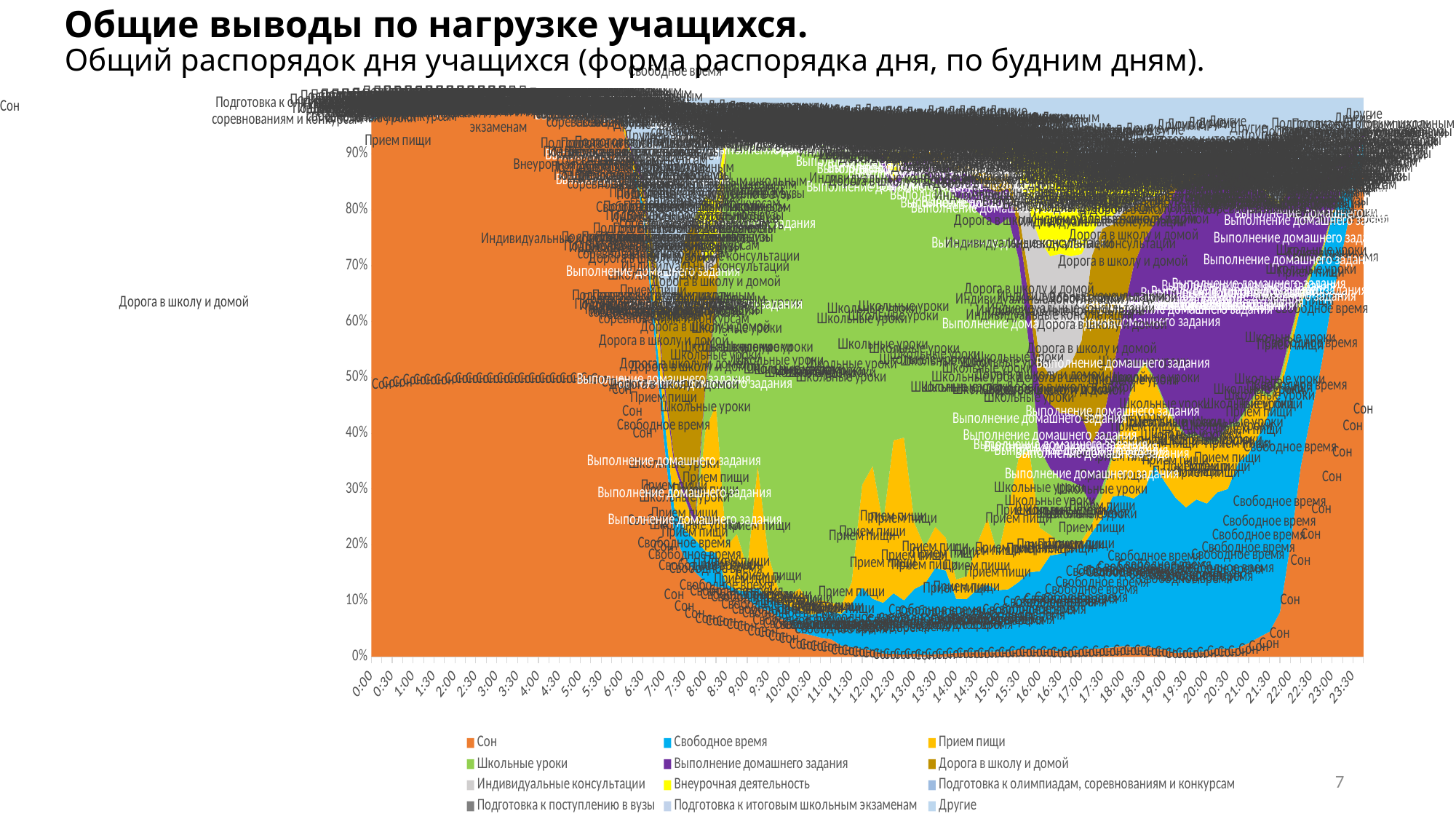
How many series does the legend list? 12 How many time points are shown along the x axis (from 0:00 to 23:30 in 30-minute steps)? 48 Does the share of "Сон" rise or fall from 0:00 to 12:00? fall Which series is larger at 0:00, "Сон" or "Свободное время"? Сон Is the share of "Сон" at 0:00 greater or less than 90%? greater Is the share of "Школьные уроки" at 10:00 greater or less than 50%? greater Does the share of "Сон" rise or fall from 19:00 to 23:30? rise Which colour represents "Сон" in the chart? Orange What kind of chart is shown on the slide? Stacked area chart Is the share of "Школьные уроки" at 0:00 greater or less than 10%? less Which colour represents "Свободное время" in the chart? Blue